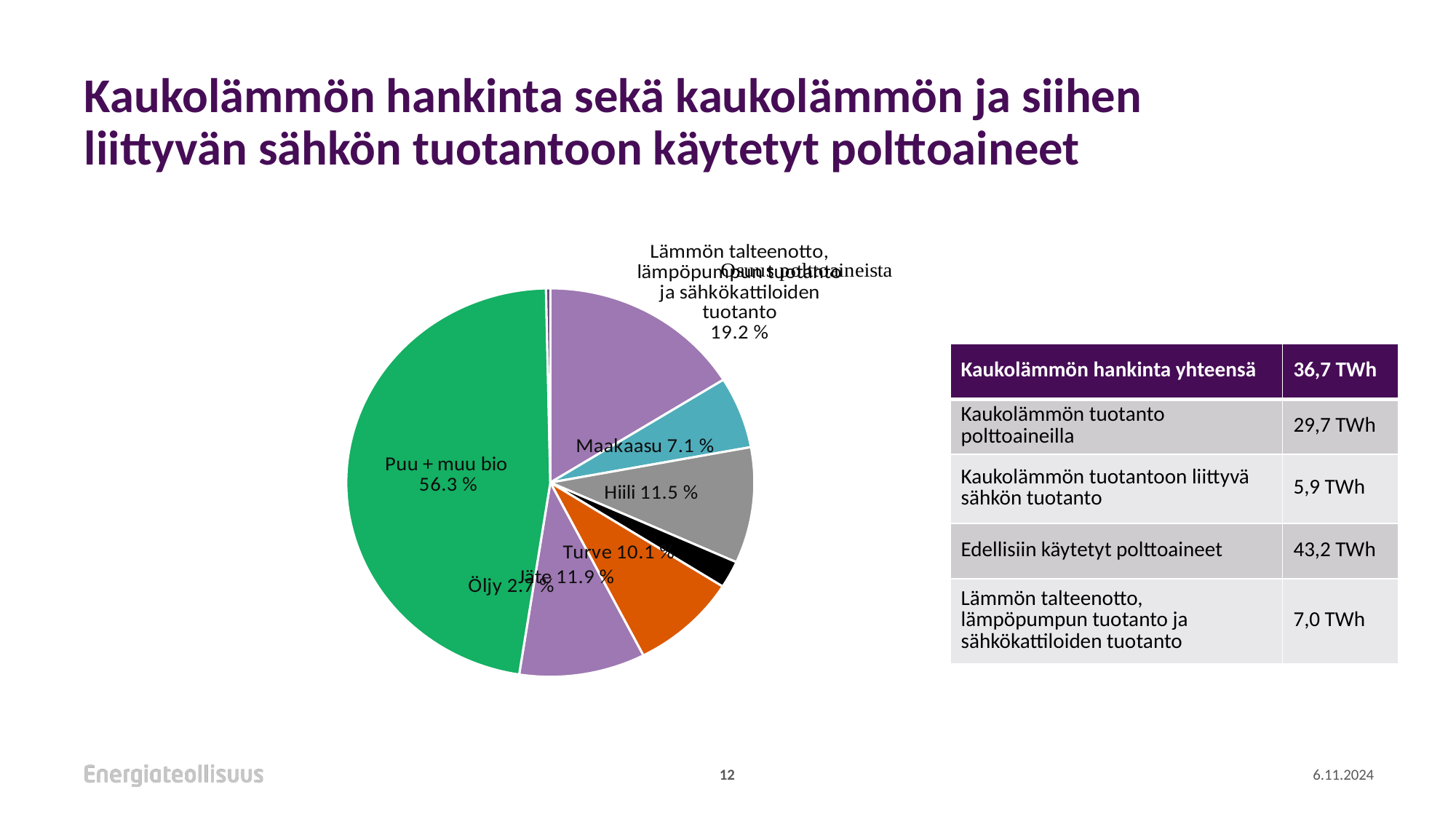
What share is shown for Öljy in the pie chart? 2.7 % What share is shown for Jäte in the pie chart? 11.9 % How many percentage points larger is the Hiili share than the Maakaasu share in the pie chart? 4.4 What share is shown for Maakaasu in the pie chart? 7.1 % What kind of chart is shown on the slide? Pie chart Which slice of the pie chart has the largest share? Puu + muu bio What share is shown for Turve in the pie chart? 10.1 % What share is shown for Hiili in the pie chart? 11.5 % Which has the larger share in the pie chart, Puu + muu bio or Hiili? Puu + muu bio What share is shown for 'Lämmön talteenotto, lämpöpumpun tuotanto ja sähkökattiloiden tuotanto' in the pie chart? 19.2 % What share does the Puu + muu bio slice have in the pie chart? 56.3 % Which of the labelled slices in the pie chart has the smallest share? Öljy